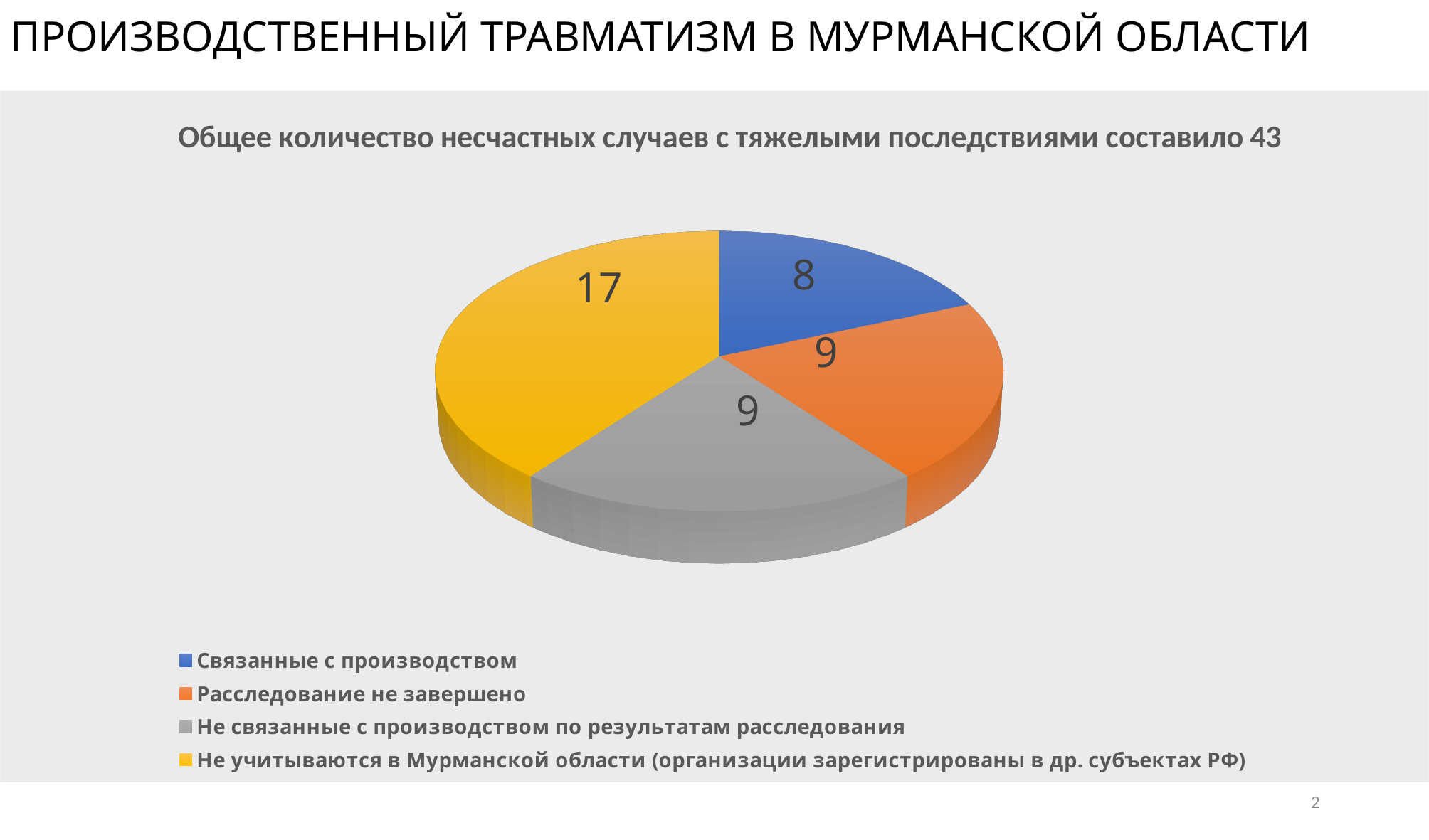
Which is larger: the value for "Связанные с производством" or the value for "Расследование не завершено"? Расследование не завершено Which category has the largest slice of the pie? Не учитываются в Мурманской области (организации зарегистрированы в др. субъектах РФ) What is the difference between the value for "Не учитываются в Мурманской области" and the value for "Связанные с производством"? 9 What kind of chart is shown on the slide? Pie chart What value is shown for the slice "Не учитываются в Мурманской области (организации зарегистрированы в др. субъектах РФ)"? 17 How many cases are shown for the category "Связанные с производством"? 8 What is the difference between the value for "Расследование не завершено" and the value for "Связанные с производством"? 1 How many slices does the pie chart have? 4 What is the total of all the slices in the pie chart? 43 What value is shown for the slice "Расследование не завершено"? 9 Which category has the smallest slice of the pie? Связанные с производством What value is shown for the slice "Не связанные с производством по результатам расследования"? 9